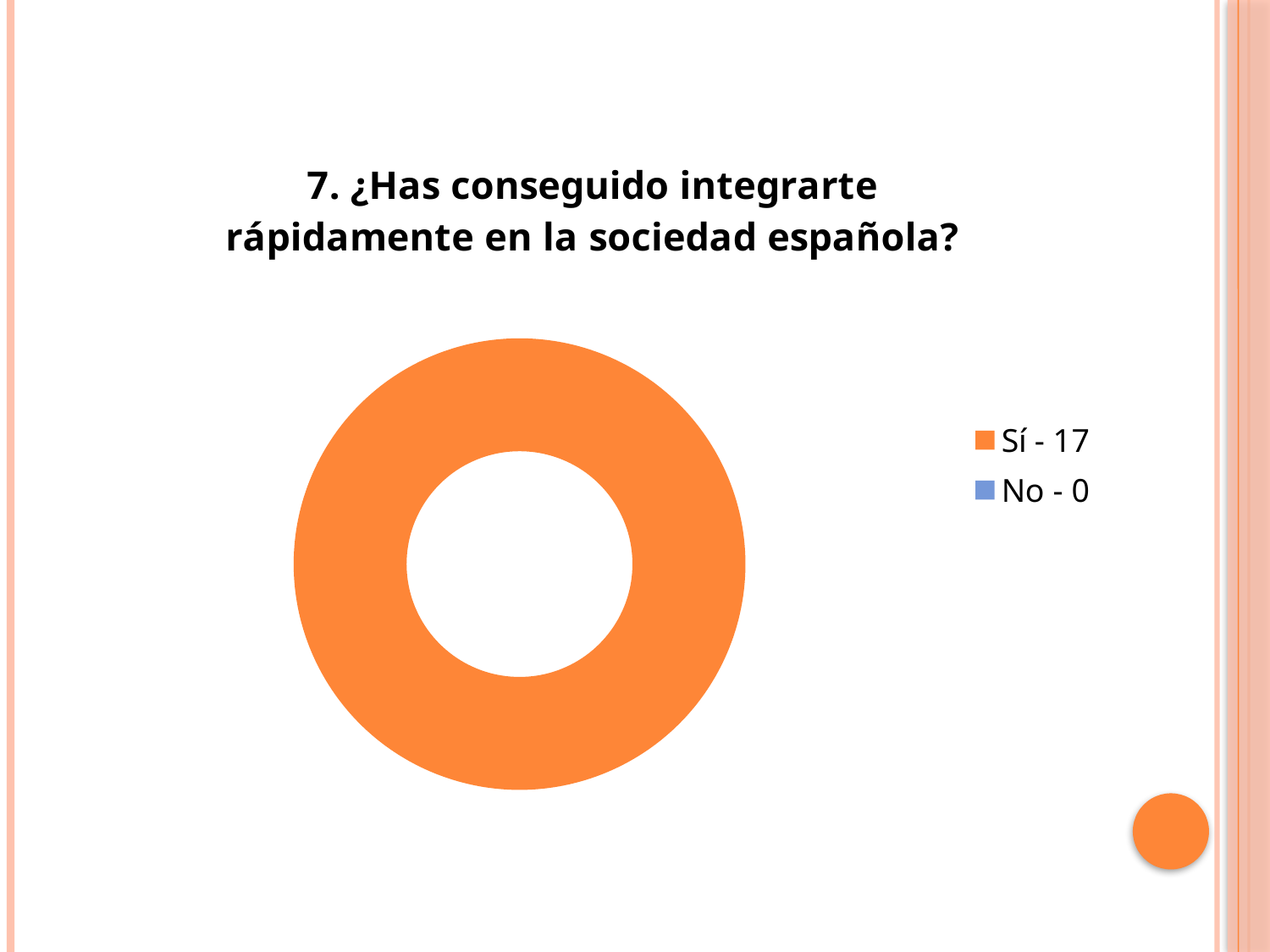
Which is larger, the value for "Sí" or the value for "No"? Sí Which category has the lowest value? No What is the value for "Sí"? 17 How many categories does the legend list? 2 What is the difference between the values for "Sí" and "No"? 17 Which category has the highest value? Sí What is the title of the chart? 7. ¿Has conseguido integrarte rápidamente en la sociedad española? What is the value for "No"? 0 What colour represents "Sí" in the chart? Orange What share of the chart does "Sí" represent? 100% What is the total of all values in the chart? 17 What kind of chart is shown on the slide? Doughnut chart